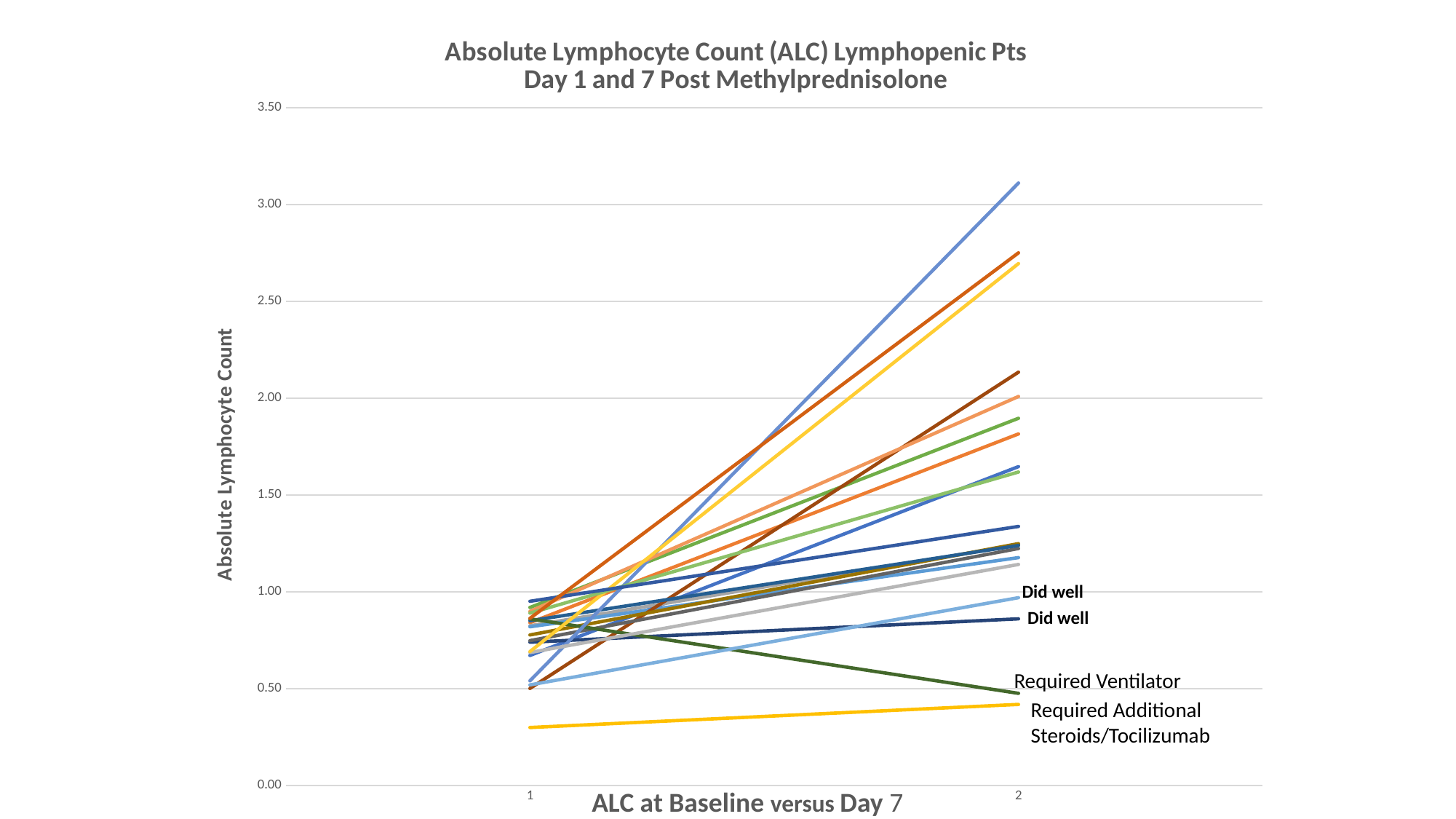
Is the value at point 2 of the highest line on the chart greater or less than 3.00? greater Is the value at point 1 of the line labelled "Required Additional Steroids/Tocilizumab" greater or less than 0.50? less Do most of the lines on the chart rise or fall from point 1 to point 2? rise What is the highest value shown on the vertical axis of the chart? 3.50 At point 2, which line is higher: the one labelled "Required Ventilator" or the one labelled "Required Additional Steroids/Tocilizumab"? Required Ventilator What is the label on the vertical axis of the chart? Absolute Lymphocyte Count Does the line labelled "Required Ventilator" rise or fall from point 1 to point 2? fall How many points are there along the x axis of the chart? 2 Does the line labelled "Required Additional Steroids/Tocilizumab" rise or fall from point 1 to point 2? rise Is the value at point 2 of the line labelled "Required Additional Steroids/Tocilizumab" greater or less than 0.50? less What kind of chart is shown on the slide? line chart What is the title of the chart? Absolute Lymphocyte Count (ALC) Lymphopenic Pts Day 1 and 7 Post Methylprednisolone